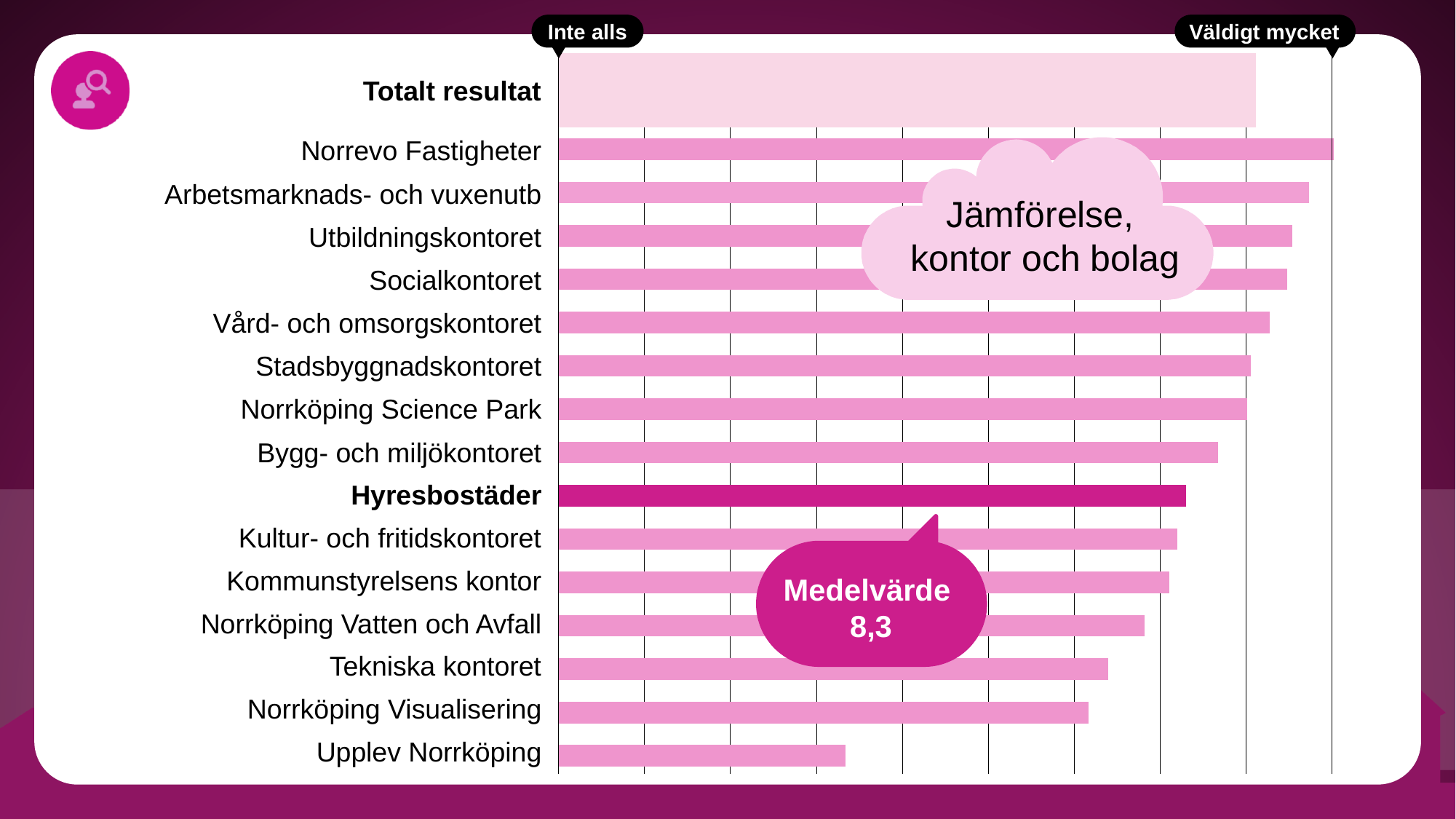
What kind of chart is shown on the slide? Bar chart Which bar is longer: Norrköping Visualisering or Upplev Norrköping? Norrköping Visualisering What is the Medelvärde (mean value) shown in the callout for Hyresbostäder? 8,3 Do the bar lengths increase or decrease going from the top organisation to the bottom one? Decrease Which bar is longer: Hyresbostäder or Totalt resultat? Totalt resultat Which organisation has the longest bar in the chart? Norrevo Fastigheter Which organisation has the shortest bar in the chart? Upplev Norrköping Which bar is longer: Bygg- och miljökontoret or Kultur- och fritidskontoret? Bygg- och miljökontoret What are the two labels at the ends of the horizontal axis? Inte alls and Väldigt mycket How many organisations are listed below the 'Totalt resultat' bar? 15 What is the title shown in the cloud shape on the chart? Jämförelse, kontor och bolag